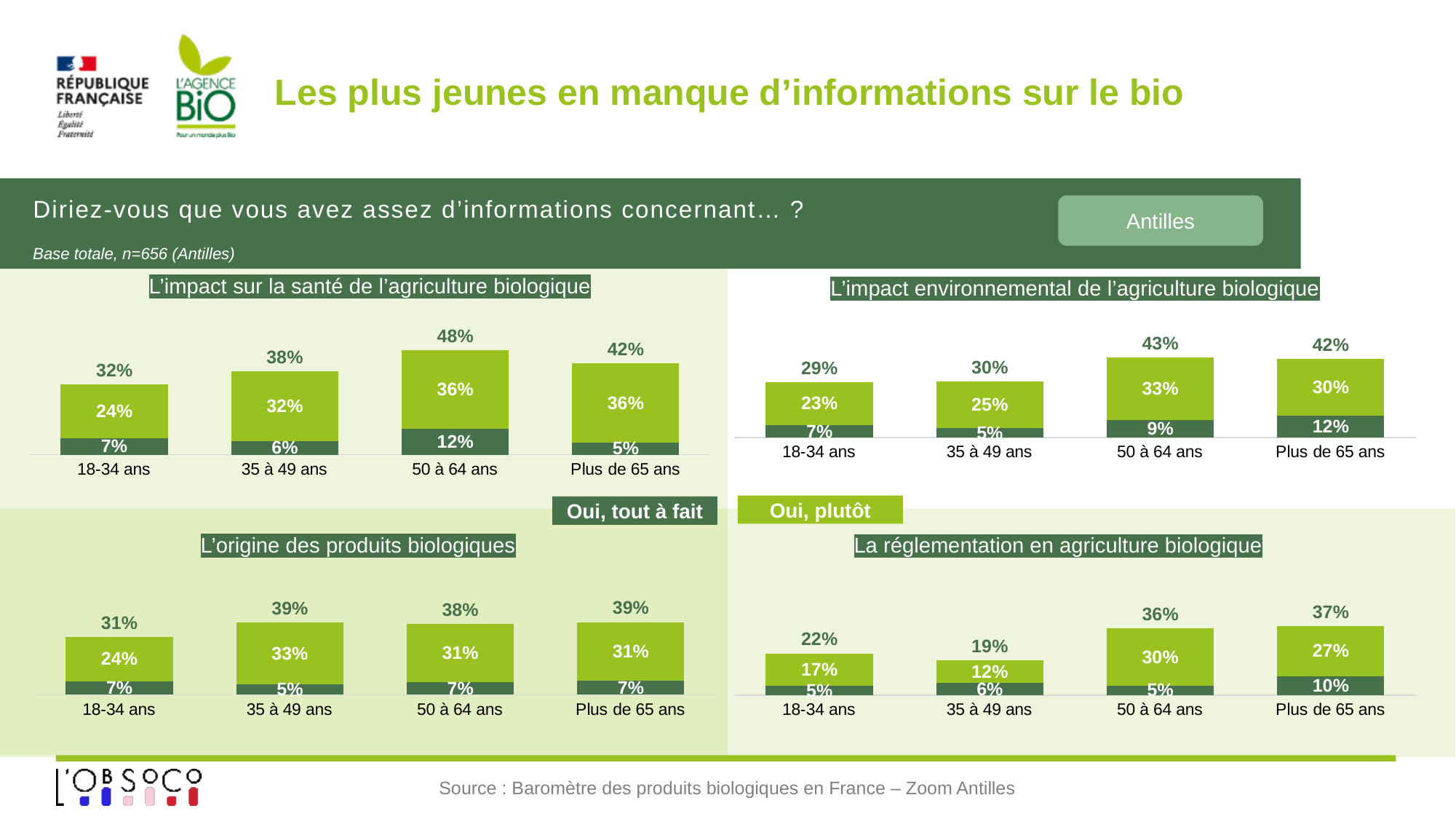
What kind of chart is 'L'origine des produits biologiques'? Stacked bar chart In the chart 'L'impact environnemental de l'agriculture biologique', what is the total shown above the bar for Plus de 65 ans? 42% How many age groups are shown in the chart 'L'impact sur la santé de l'agriculture biologique'? 4 In the chart 'L'impact sur la santé de l'agriculture biologique', what is the 'Oui, tout à fait' value for 50 à 64 ans? 12% How many series does the legend list for the charts on this slide? 2 In the chart 'L'origine des produits biologiques', which age group has the lowest total? 18-34 ans In the chart 'La réglementation en agriculture biologique', which total is larger: 18-34 ans or 50 à 64 ans? 50 à 64 ans In the chart 'L'impact environnemental de l'agriculture biologique', what is the 'Oui, plutôt' value for 35 à 49 ans? 25% In the chart 'L'impact sur la santé de l'agriculture biologique', which age group has the highest total? 50 à 64 ans In the chart 'L'origine des produits biologiques', what is the 'Oui, plutôt' value for 35 à 49 ans? 33% In the chart 'La réglementation en agriculture biologique', what is the difference between the totals for Plus de 65 ans and 35 à 49 ans? 18% In the chart 'La réglementation en agriculture biologique', what is the 'Oui, tout à fait' value for Plus de 65 ans? 10%